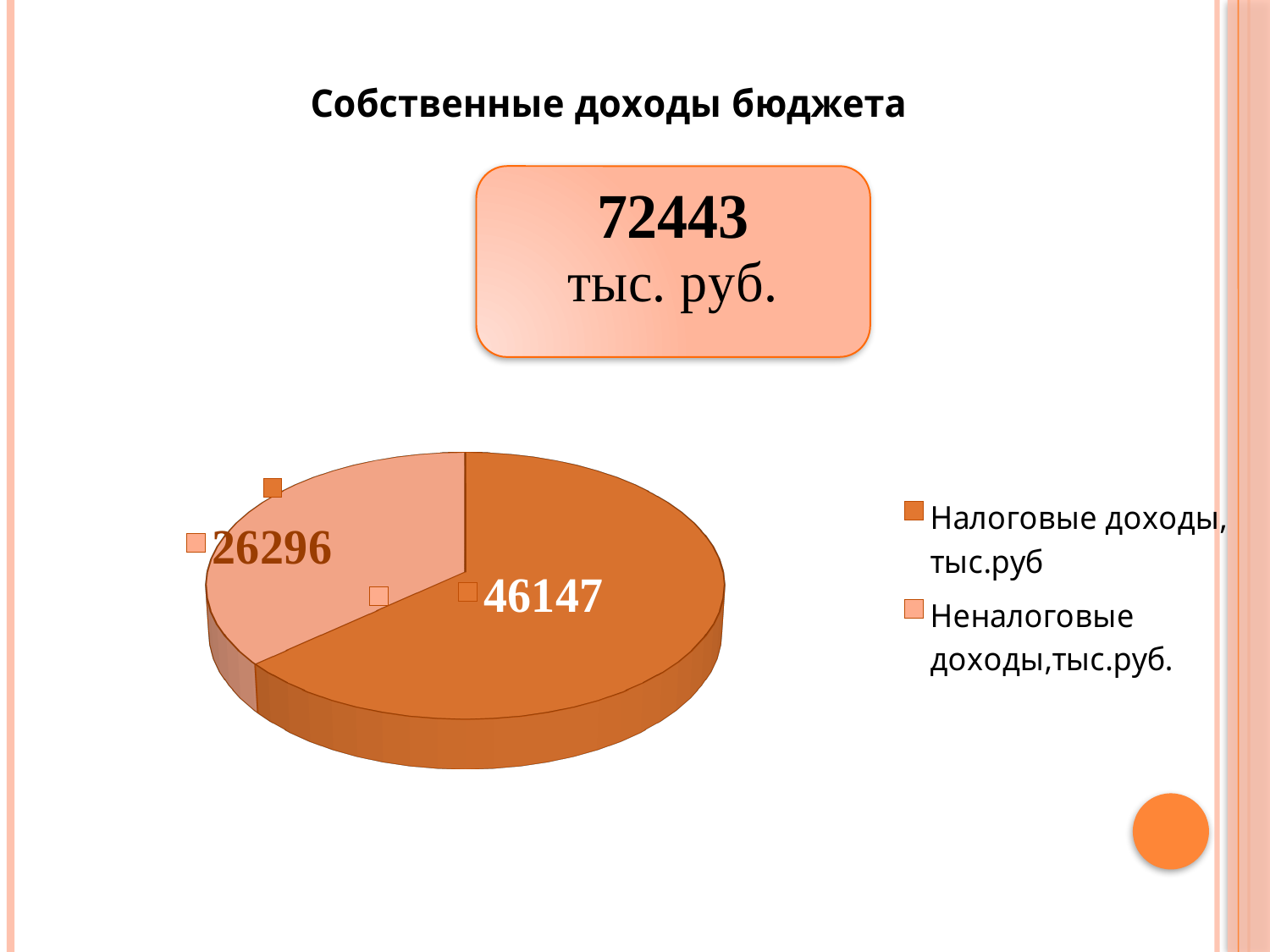
What is the title of the chart? Собственные доходы бюджета What type of chart is shown on the slide? pie chart What is the value for Неналоговые доходы, тыс.руб.? 26296 What is the difference between Налоговые доходы (46147) and Неналоговые доходы (26296)? 19851 Which slice of the pie is the smallest? Неналоговые доходы, тыс.руб. How many slices does the pie chart have? 2 What is the total of the two slices in the pie chart? 72443 How many entries does the legend list? 2 What is the value for Налоговые доходы, тыс.руб? 46147 Which is larger: Налоговые доходы or Неналоговые доходы? Налоговые доходы Which slice of the pie is the largest? Налоговые доходы, тыс.руб What share of the pie does Налоговые доходы represent, to one decimal place? 63.7%